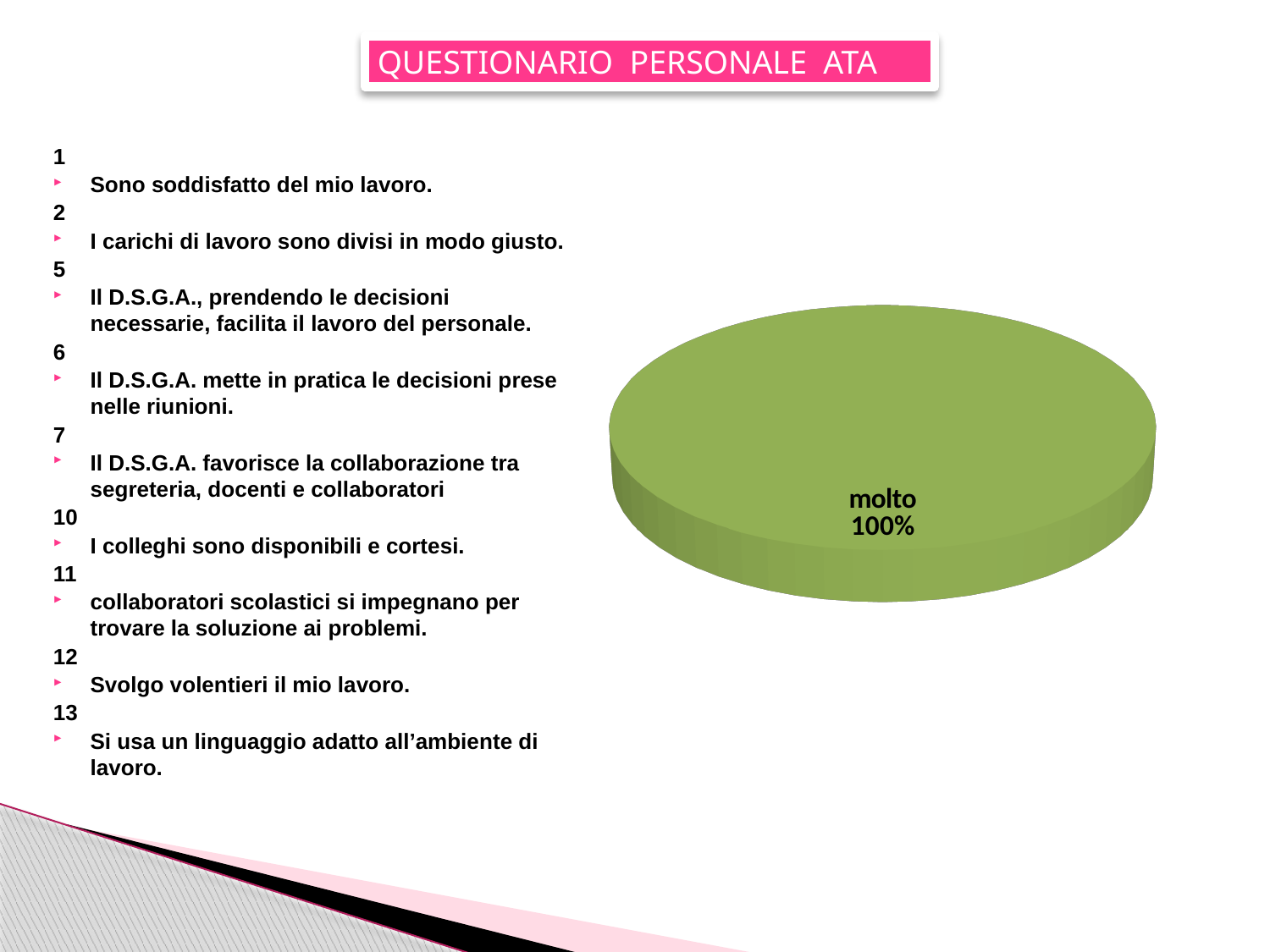
What share of the pie does the "molto" slice represent? 100% What is the label of the only slice in the pie chart? molto What kind of chart is shown on the slide? pie chart What colour is the "molto" slice in the pie chart? green How many slices does the pie chart have? 1 What is the value shown for the "molto" category in the pie chart? 100% Which category is the largest in the pie chart? molto